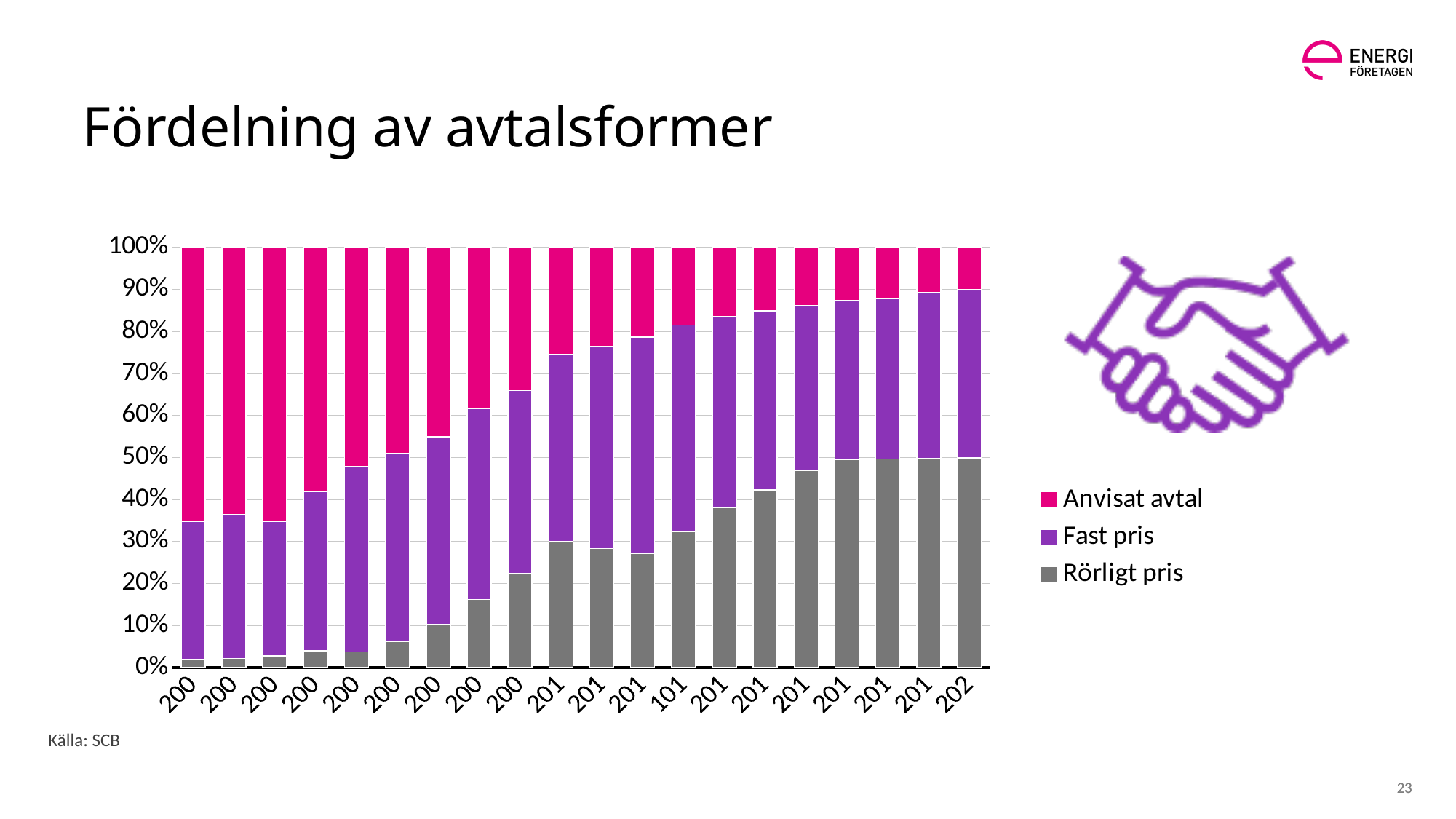
In the leftmost bar, is the share of Anvisat avtal greater or less than 60%? greater In the leftmost bar, is the share of Rörligt pris greater or less than 10%? less Which series is shown in grey in the legend? Rörligt pris How many bars are plotted in the chart? 20 What is the title of the chart slide? Fördelning av avtalsformer Does the share of Anvisat avtal rise or fall from the leftmost bar to the rightmost bar? Fall In the leftmost bar, which series has the largest share? Anvisat avtal Does the share of Rörligt pris rise or fall from the leftmost bar to the rightmost bar? Rise How many series does the legend list? 3 What kind of chart is shown on the slide? Stacked bar chart What is the total of each stacked bar? 100% In the rightmost bar, which is larger: the share of Rörligt pris or the share of Anvisat avtal? Rörligt pris